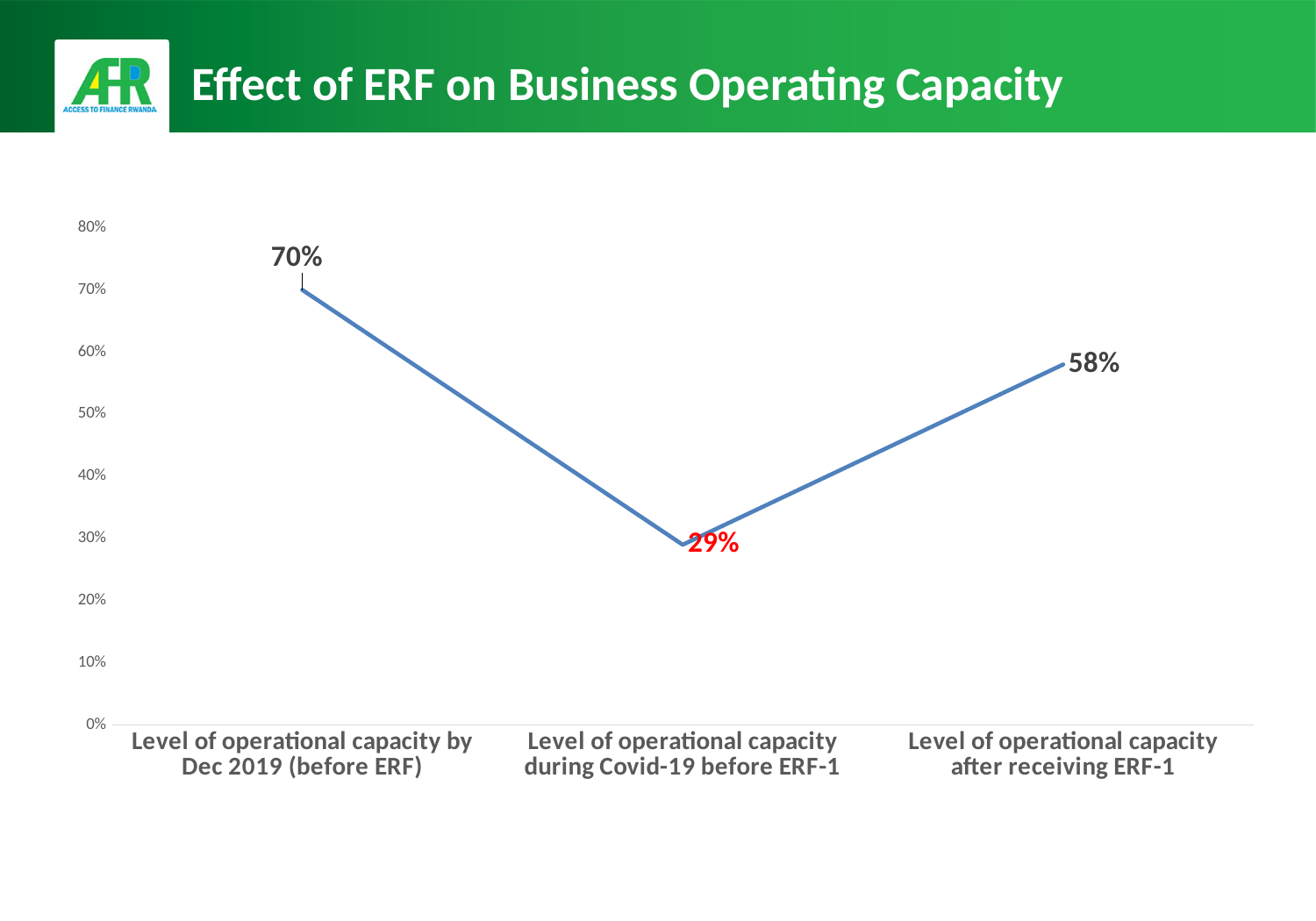
Which category has the lowest operational capacity? Level of operational capacity during Covid-19 before ERF-1 Is the operational capacity after receiving ERF-1 greater or less than 50%? greater What kind of chart is shown on the slide? Line chart What is the level of operational capacity after receiving ERF-1? 58% What is the level of operational capacity during Covid-19 before ERF-1? 29% Which is larger: the operational capacity by Dec 2019 (before ERF) or after receiving ERF-1? Level of operational capacity by Dec 2019 (before ERF) What is the title of the slide? Effect of ERF on Business Operating Capacity Which category has the highest operational capacity? Level of operational capacity by Dec 2019 (before ERF) By how much did operational capacity increase from during Covid-19 before ERF-1 to after receiving ERF-1? 29% What is the level of operational capacity by Dec 2019 (before ERF)? 70% What is the difference between the operational capacity before ERF (Dec 2019) and during Covid-19 before ERF-1? 41% How many data points are plotted on the chart? 3